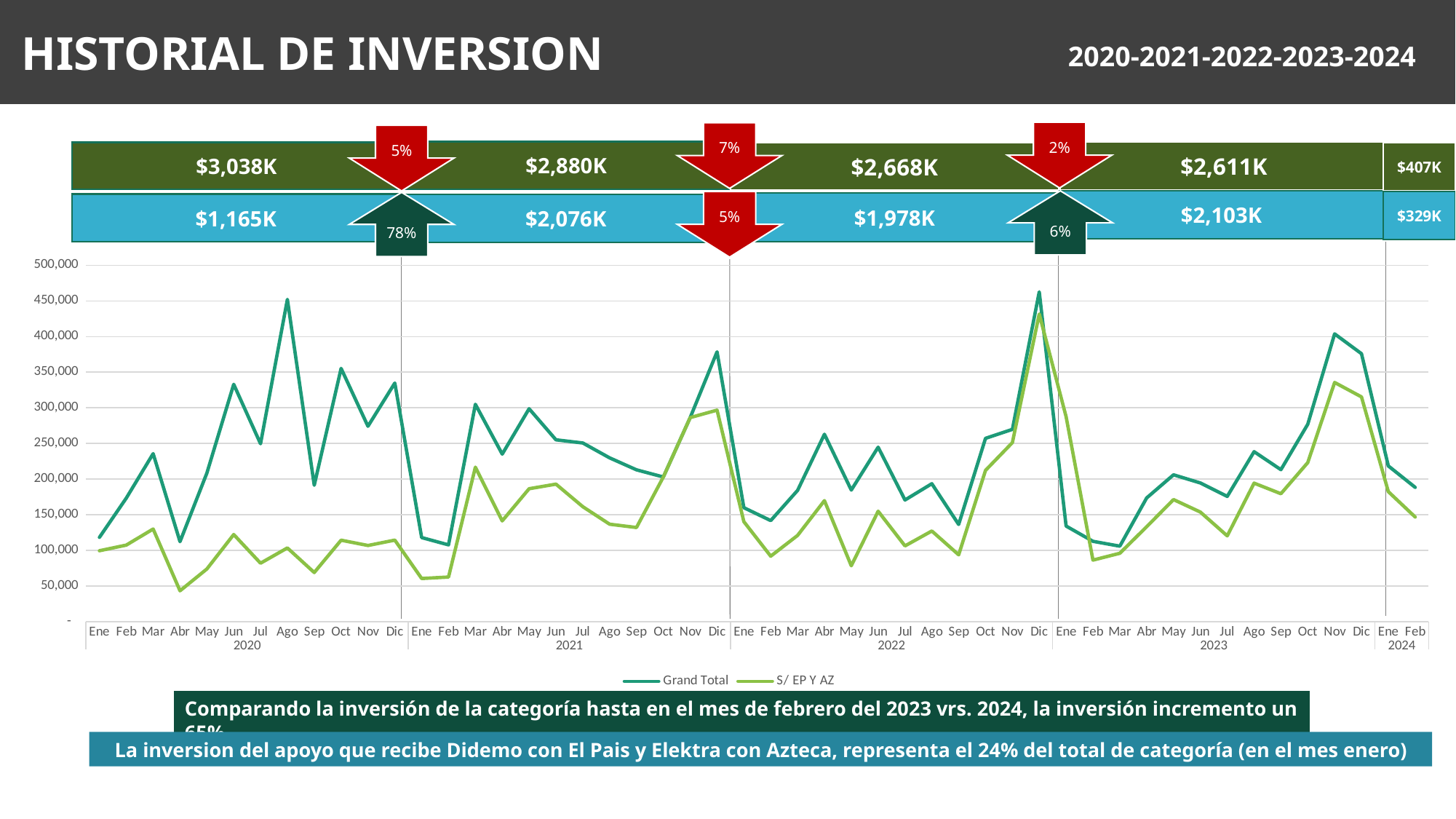
Is the Grand Total value for Ene 2021 greater or less than 150,000? less What kind of chart is shown on the slide? line chart How many series does the chart legend list? 2 What are the two series named in the chart legend? Grand Total and S/ EP Y AZ Is the Grand Total value for Ago 2020 greater or less than 400,000? greater In which month does the S/ EP Y AZ series reach its highest value? Dic 2022 Is the S/ EP Y AZ value for Abr 2020 greater or less than 50,000? less Which is larger, the Grand Total value for Nov 2023 or the Grand Total value for Nov 2022? Nov 2023 How many years are labelled along the x axis of the chart? 5 Does the Grand Total series rise or fall from Nov 2023 to Feb 2024? fall How many months are plotted for 2024 on the chart? 2